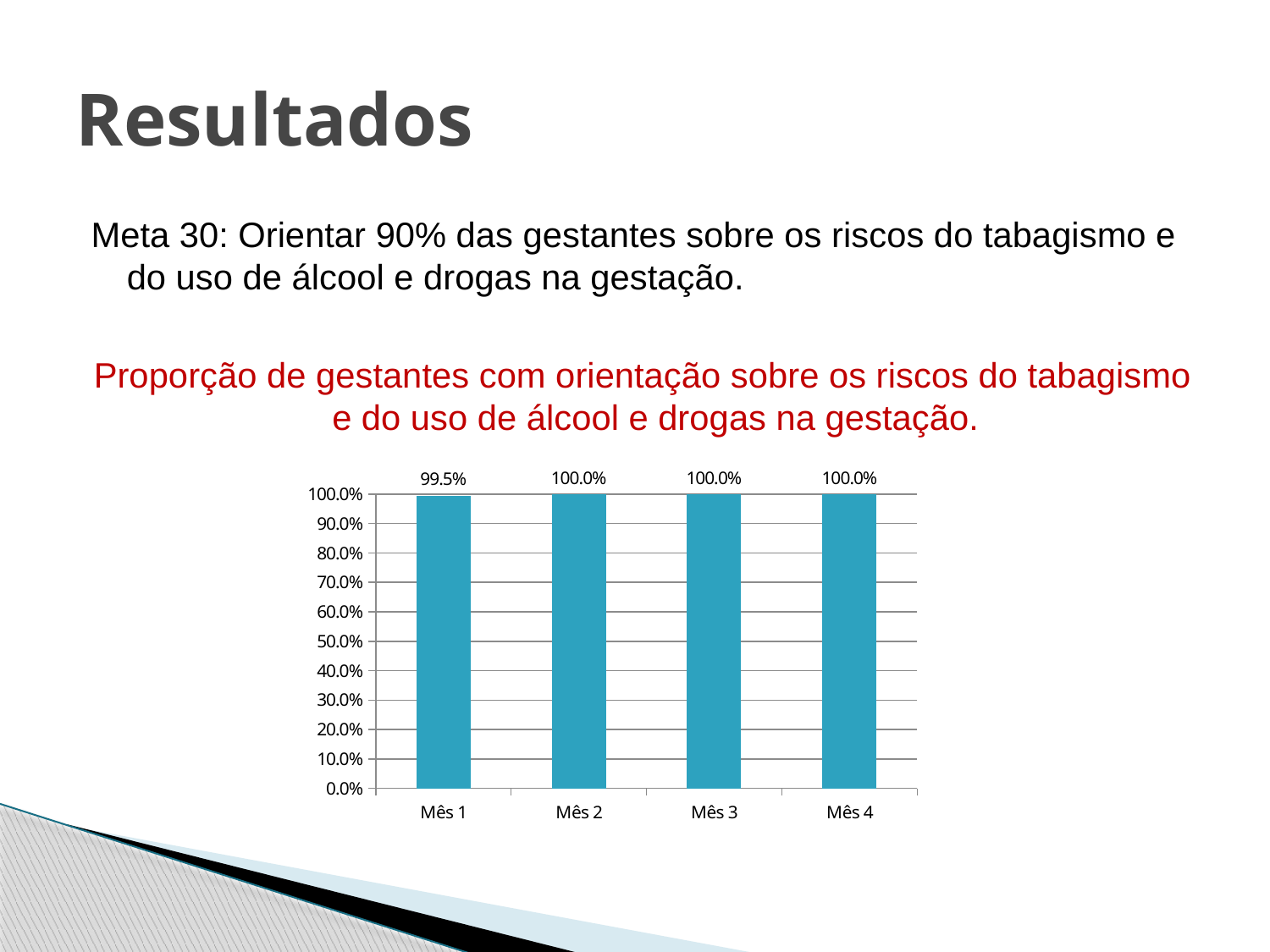
What is the highest tick value shown on the y axis? 100.0% What is the value for Mês 1? 99.5% What is the value for Mês 2? 100.0% Is the value for Mês 3 greater or less than 90.0%? greater What kind of chart is shown on the slide? bar chart What colour are the bars in the chart? blue Which is larger, the value for Mês 1 or the value for Mês 3? Mês 3 How many months are shown on the x axis? 4 Which month has the lowest value? Mês 1 What is the value for Mês 4? 100.0% What is the difference between the values for Mês 2 and Mês 1? 0.5%